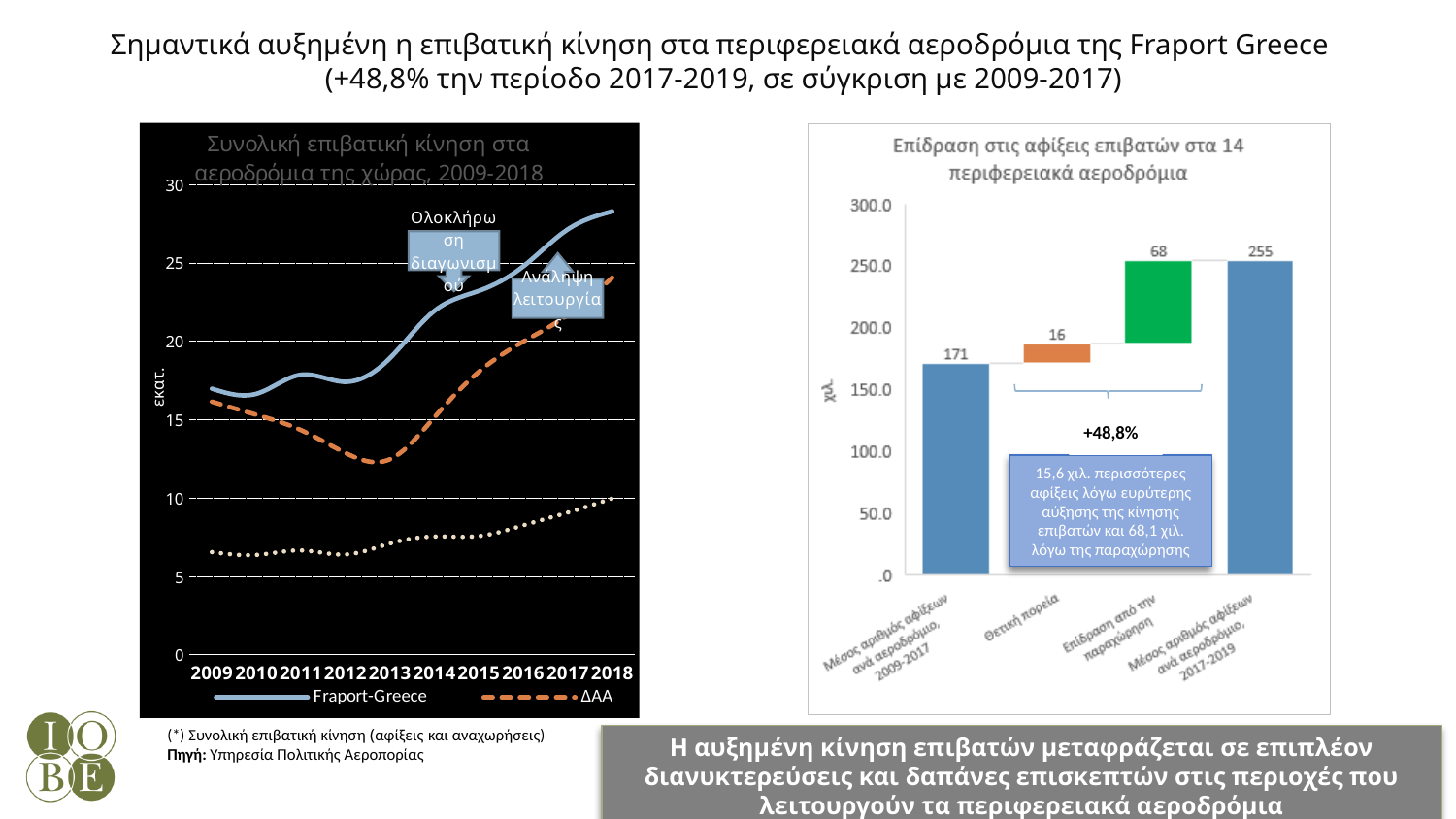
On the right chart, what is the difference between the 2017-2019 average (255) and the 2009-2017 average (171)? 84 On the right chart, what is the value for 'Μέσος αριθμός αφίξεων ανά αεροδρόμιο, 2009-2017'? 171 What kind of chart is the right chart? bar chart On the right chart, what is the value labelled for 'Επίδραση από την παραχώρηση'? 68 On the left chart, is the value for ΔΑΑ in 2013 greater or less than 15? less On the right chart, what is the value labelled for 'Θετική πορεία'? 16 On the right chart, what is the value for 'Μέσος αριθμός αφίξεων ανά αεροδρόμιο, 2017-2019'? 255 On the left chart, in 2018, which series is higher: Fraport-Greece or ΔΑΑ? Fraport-Greece On the left chart, how many years are shown on the x axis? 10 On the right chart, how many categories are shown on the x axis? 4 On the right chart, which category has the smallest labelled value? Θετική πορεία On the left chart, is the value for Fraport-Greece in 2018 greater or less than 25? greater